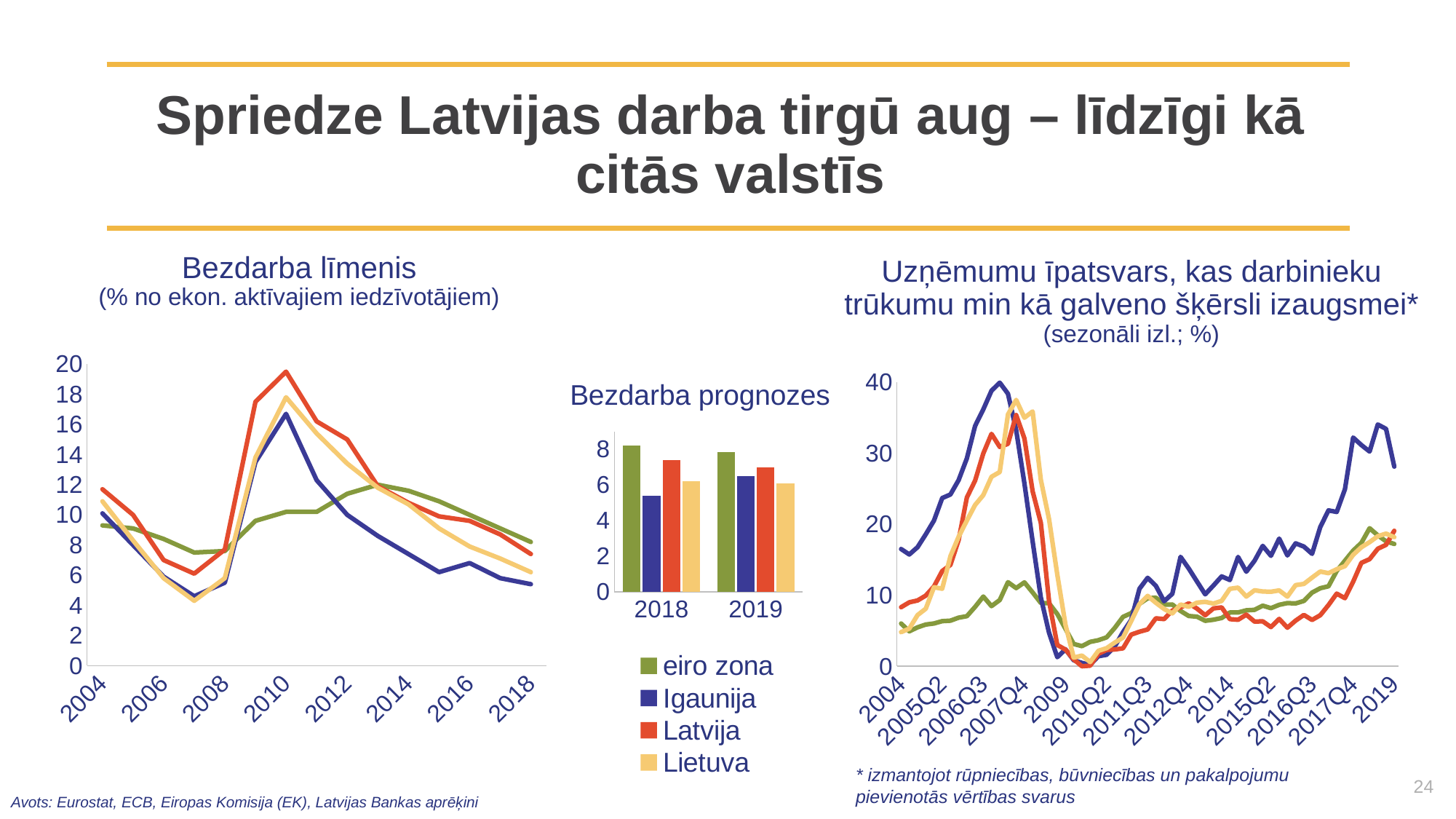
In the 'Bezdarba prognozes' chart, which series has the highest value for 2018? eiro zona In the 'Bezdarba prognozes' chart, which series has the lowest value for 2018? Igaunija In the 'Bezdarba līmenis' chart, does the eiro zona line rise or fall from 2014 to 2018? fall In the 'Bezdarba prognozes' chart, which is larger for 2019: eiro zona or Lietuva? eiro zona In the 'Bezdarba līmenis' chart, is the peak value for Latvija around 2010 greater or less than 18? greater In the 'Bezdarba prognozes' chart, is the value for Latvija in 2018 greater or less than 6? greater In the 'Bezdarba prognozes' chart, is the value for Igaunija in 2018 greater or less than 6? less In the 'Bezdarba līmenis' chart, which series reaches the highest peak around 2010? Latvija In the 'Uzņēmumu īpatsvars' chart, which series reaches the highest peak around 2007? Igaunija What kind of chart is the 'Bezdarba prognozes' chart? bar chart In the 'Bezdarba prognozes' chart, how many years are shown on the x axis? 2 How many series does the legend list? 4